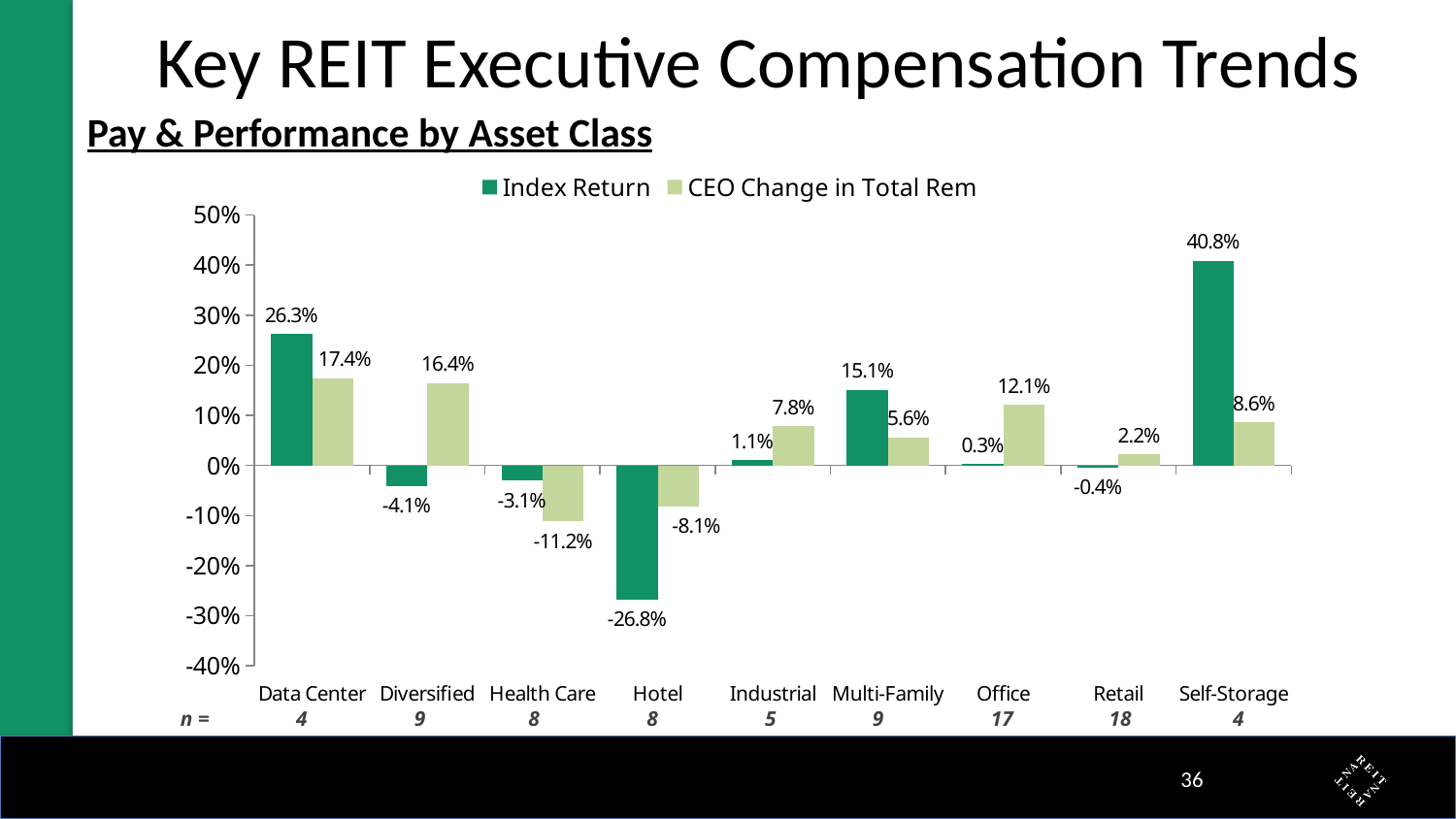
What is the CEO Change in Total Rem for Office? 12.1% What is the Index Return for Hotel? -26.8% How many asset classes are shown on the x axis? 9 What is the Index Return for Data Center? 26.3% What is the n value shown for Retail? 18 Which is larger for Multi-Family: the Index Return or the CEO Change in Total Rem? Index Return How many series does the legend list? 2 Which asset class has the lowest CEO Change in Total Rem? Health Care What kind of chart is shown on the slide? Bar chart What is the difference between the Index Return and the CEO Change in Total Rem for Self-Storage? 32.2% What is the CEO Change in Total Rem for Diversified? 16.4% Which asset class has the highest Index Return? Self-Storage